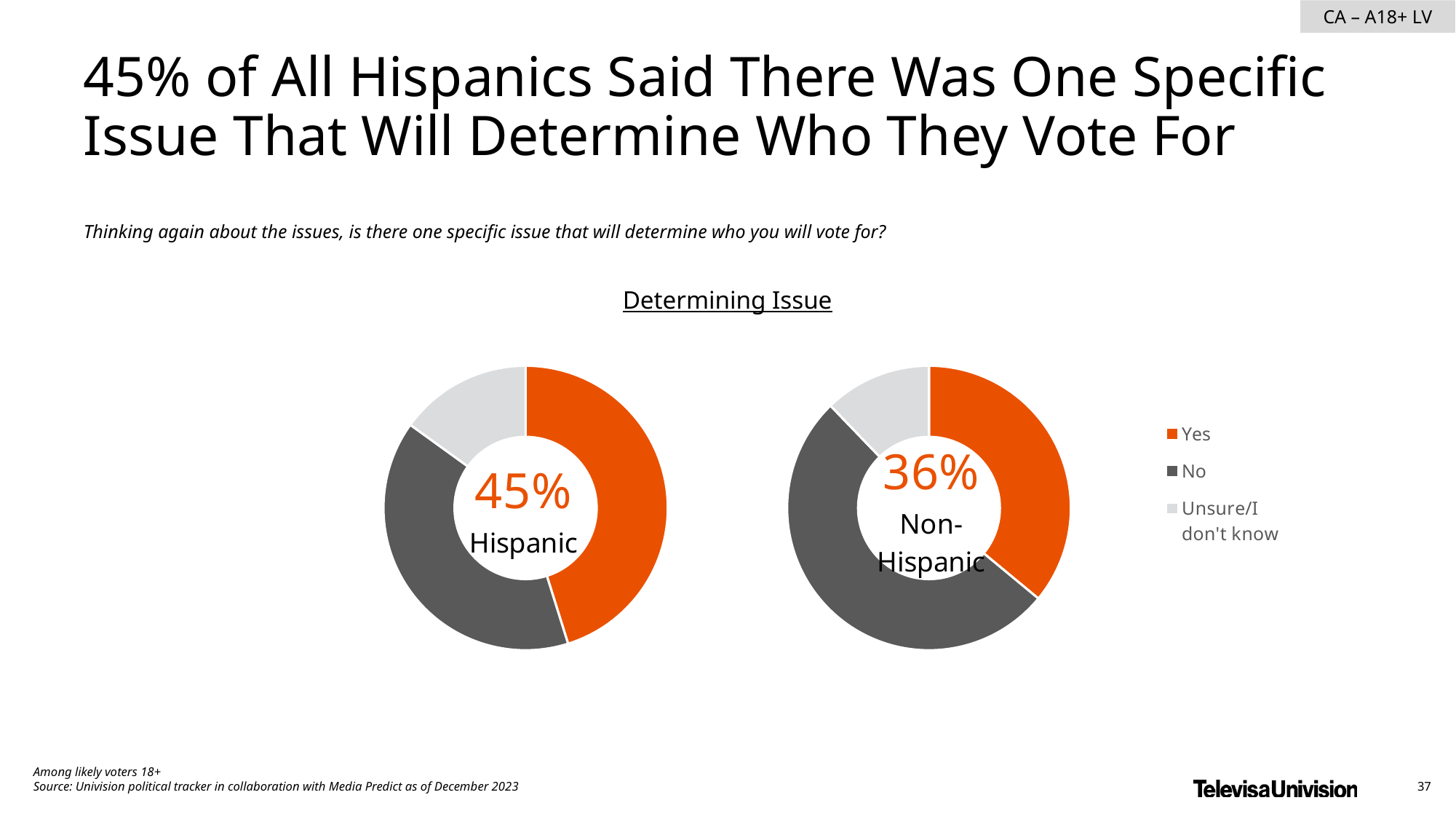
What is the difference between the Yes share for Hispanic and the Yes share for Non-Hispanic? 9 percentage points In the Non-Hispanic donut chart, which response has the largest slice? No What is the title shown above the two donut charts? Determining Issue Which group has the larger Yes share, Hispanic or Non-Hispanic? Hispanic In the Hispanic donut chart, which slice is larger, Yes or Unsure/I don't know? Yes In the Hispanic donut chart, which response has the smallest slice? Unsure/I don't know In the Non-Hispanic donut chart, which response has the smallest slice? Unsure/I don't know In the Non-Hispanic donut chart, what percentage answered Yes? 36% What type of chart is used to show the Determining Issue data? Pie (donut) chart How many response categories does the legend list? 3 Which colour represents the Yes response in the charts? Orange In the Hispanic donut chart, what percentage answered Yes? 45%